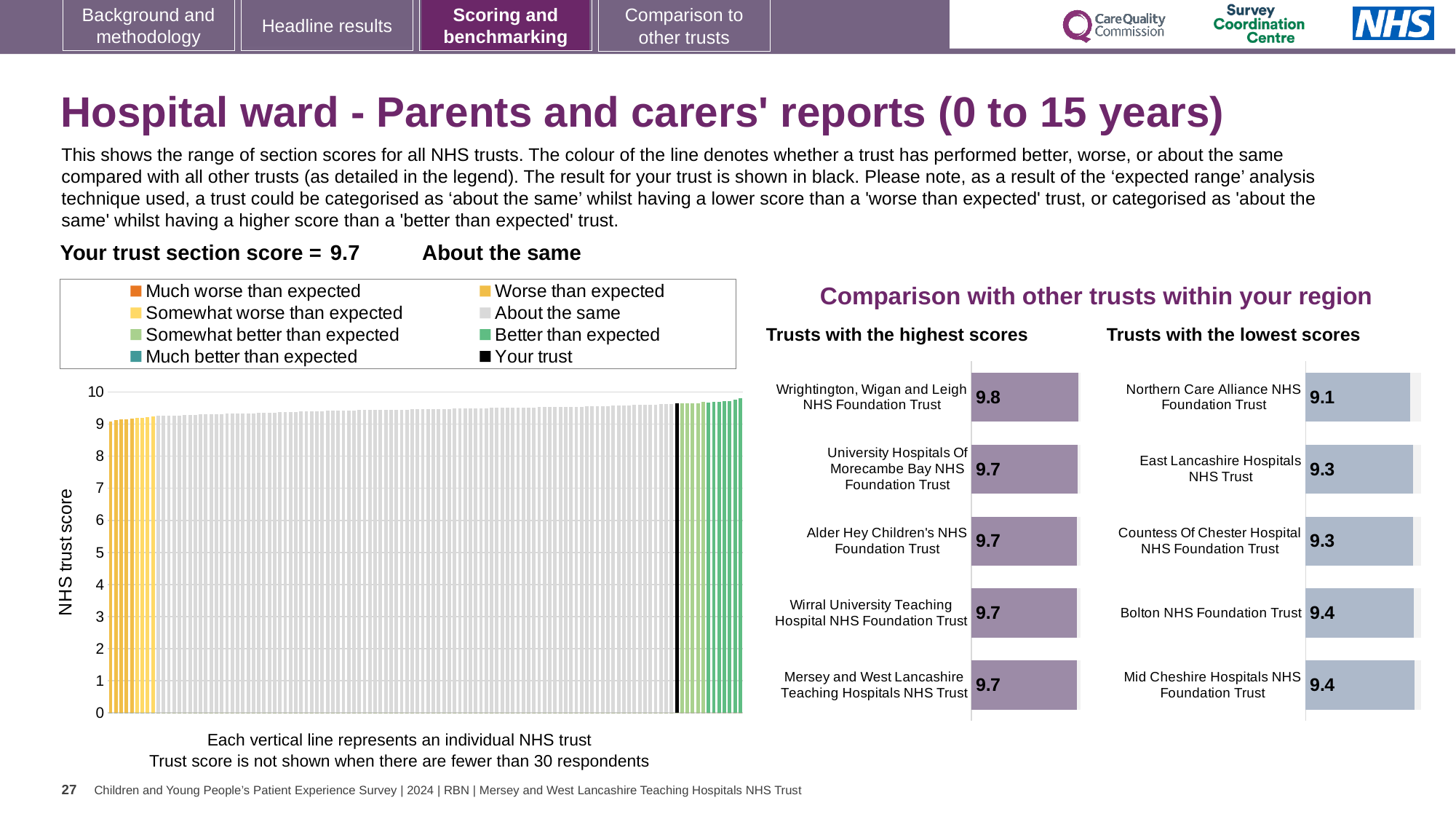
In the 'Trusts with the lowest scores' chart, which has the larger score: East Lancashire Hospitals NHS Trust or Bolton NHS Foundation Trust? Bolton NHS Foundation Trust What is the section score for your trust shown on the slide? 9.7 What kind of chart is the main chart showing NHS trust scores on the left of the slide? Bar chart In the 'Trusts with the lowest scores' chart, what is the score for Northern Care Alliance NHS Foundation Trust? 9.1 In the 'Trusts with the lowest scores' chart, what is the score for Bolton NHS Foundation Trust? 9.4 How many trusts are shown in the 'Trusts with the highest scores' chart? 5 In the 'Trusts with the highest scores' chart, which trust has the highest score? Wrightington, Wigan and Leigh NHS Foundation Trust In the 'Trusts with the highest scores' chart, what is the score for Wrightington, Wigan and Leigh NHS Foundation Trust? 9.8 In the 'Trusts with the lowest scores' chart, which trust has the lowest score? Northern Care Alliance NHS Foundation Trust How many entries does the legend of the main NHS trust score chart list? 8 In the 'Trusts with the lowest scores' chart, what is the difference between the scores of Bolton NHS Foundation Trust and Northern Care Alliance NHS Foundation Trust? 0.3 What is the label on the vertical axis of the main chart on the left of the slide? NHS trust score